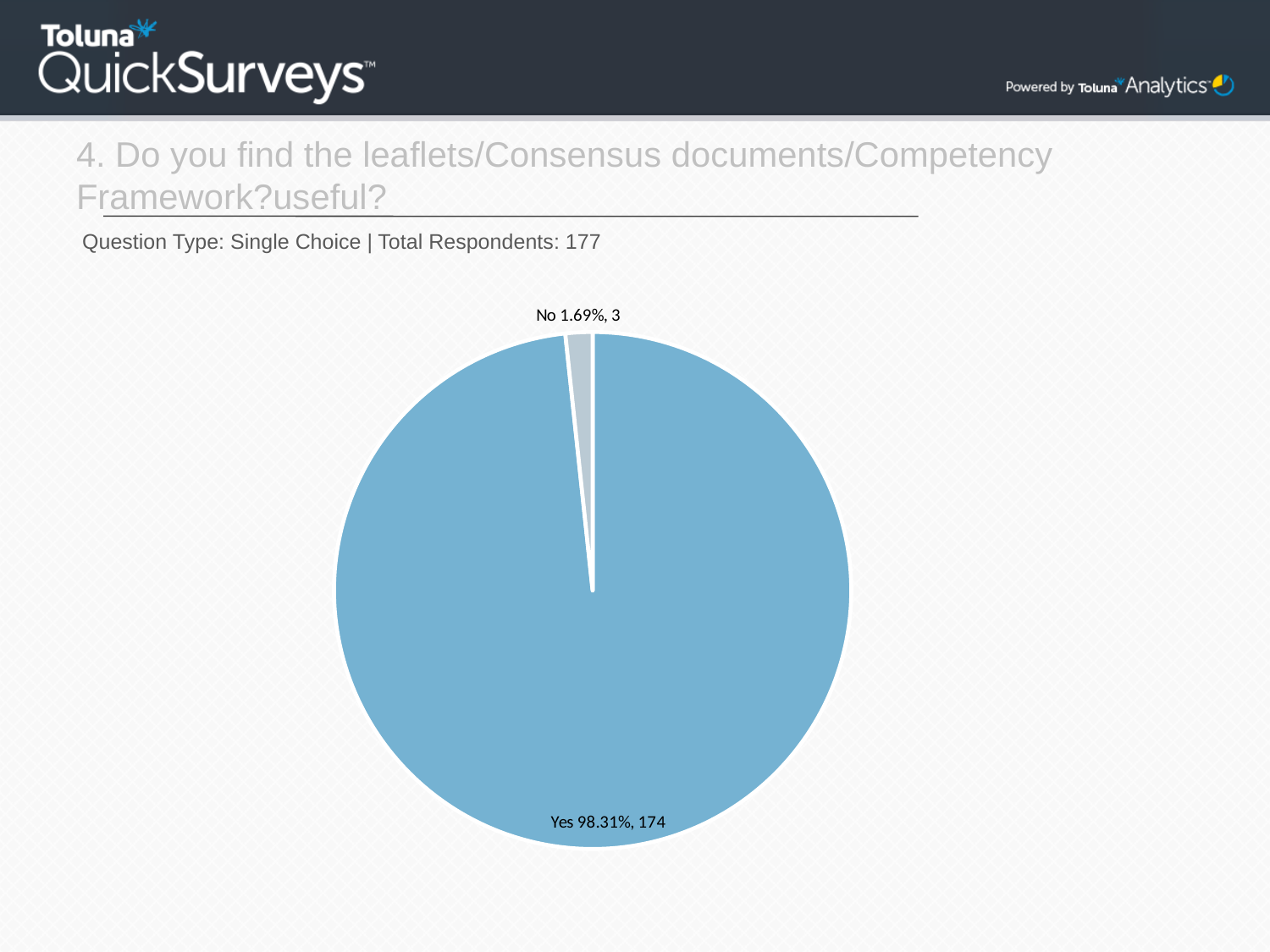
Which response has the largest share of the pie? Yes How many respondents answered No? 3 What is the difference in respondent counts between Yes and No? 171 What percentage of respondents answered Yes? 98.31% What percentage of respondents answered No? 1.69% How many slices does the pie chart have? 2 What kind of chart is shown on the slide? Pie chart What is the question type stated on the slide? Single Choice What is the total number of respondents shown on the slide? 177 Which response has the smallest share of the pie? No How many respondents answered Yes? 174 Which response received more respondents, Yes or No? Yes